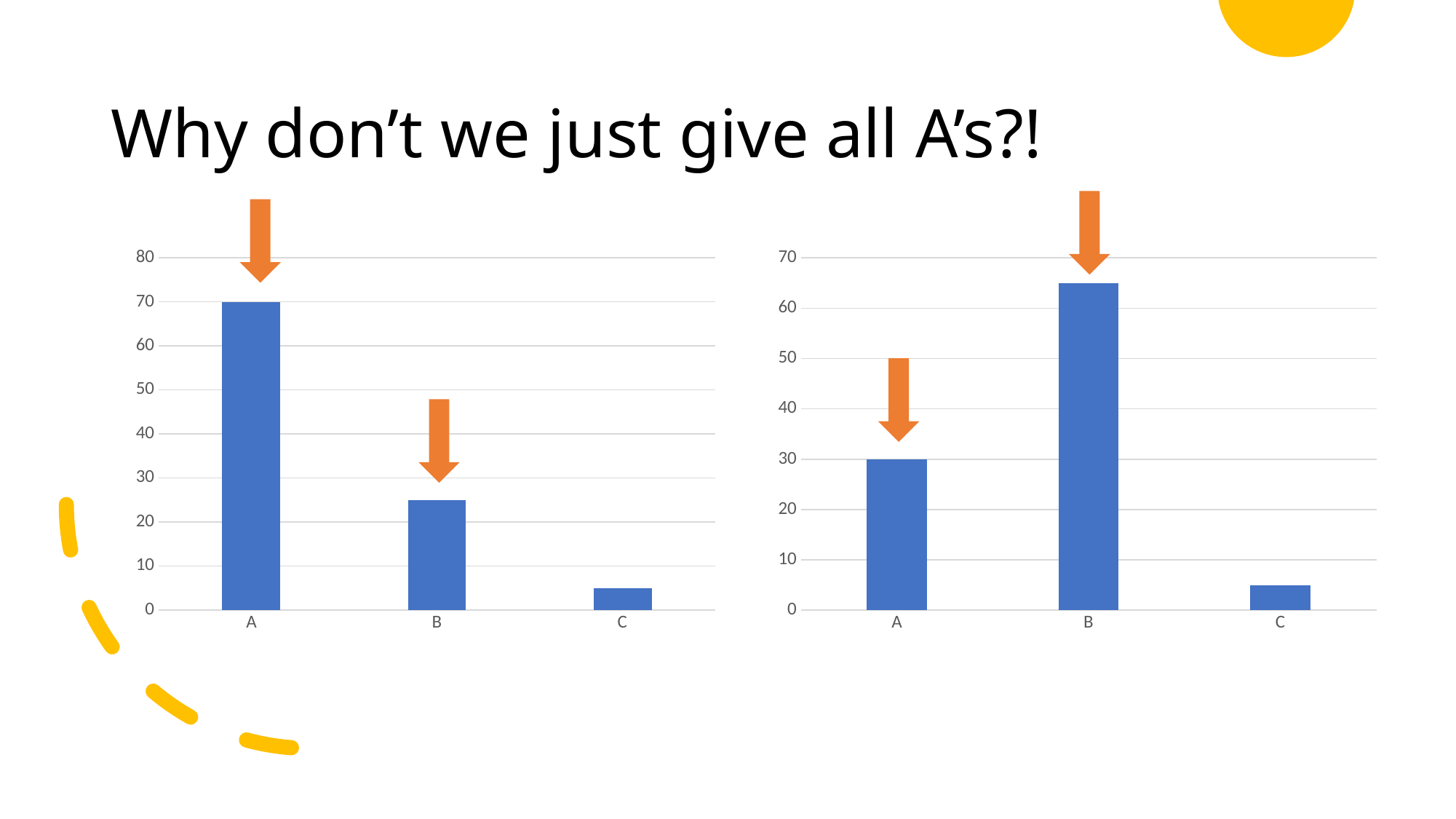
In the right chart, which category has the highest bar? B In the left chart, which category has the lowest bar? C What kind of chart is the right chart? bar chart In the left chart, is the value for B greater or less than 20? greater In the right chart, which category has the lowest bar? C In the left chart, which category has the highest bar? A In the right chart, which is larger, the value for A or the value for B? B In the left chart, what is the value for A? 70 In the right chart, is the value for B greater or less than 60? greater In the right chart, is the value for C greater or less than 10? less How many categories are shown on the x axis of the left chart? 3 In the right chart, what is the value for A? 30